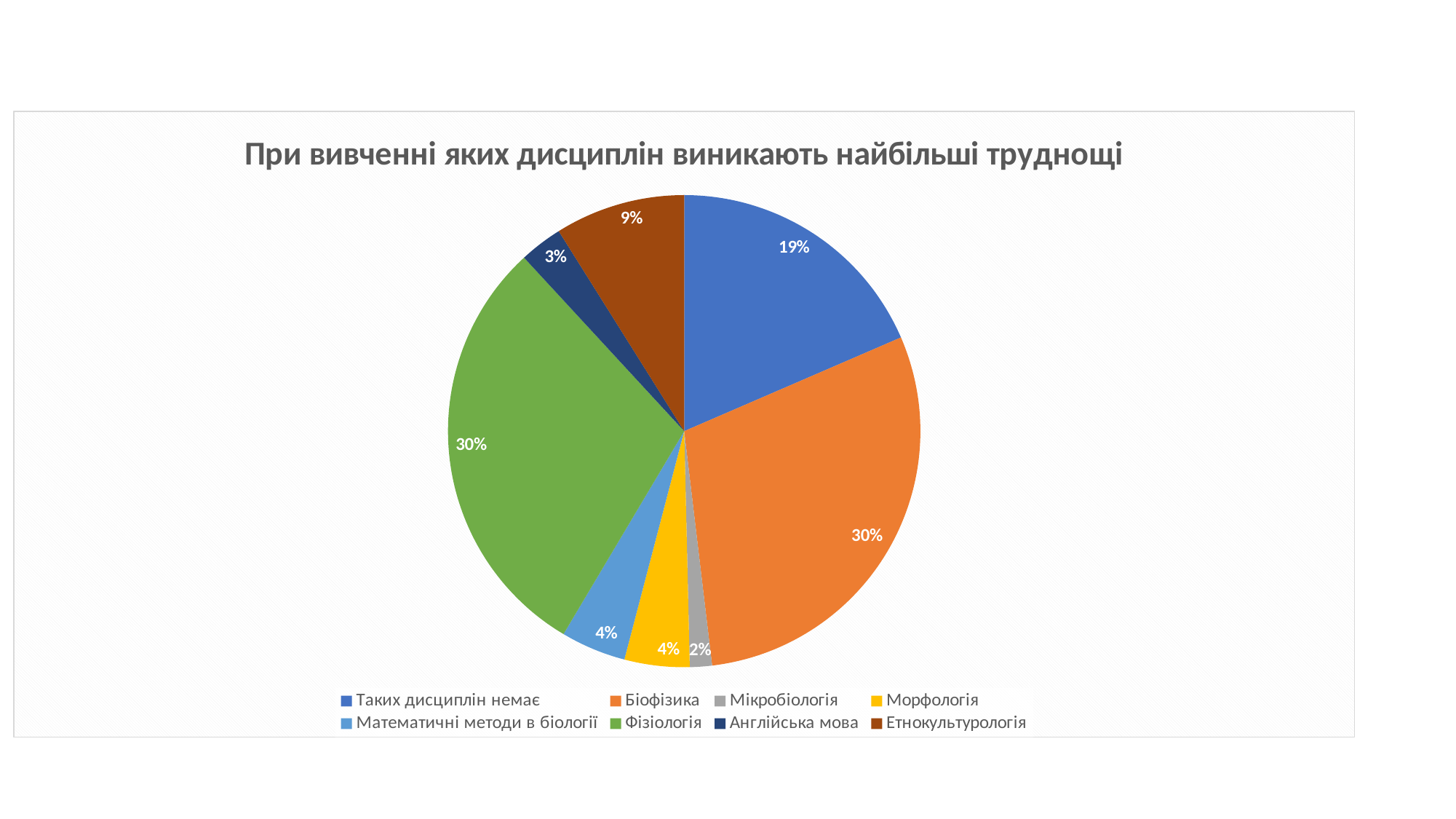
What percentage is shown for Англійська мова? 3% How many categories does the pie chart have? 8 Which is larger, the slice for Таких дисциплін немає or the slice for Етнокультурологія? Таких дисциплін немає What colour is the slice for Морфологія? yellow What is the difference in percentage points between Фізіологія and Таких дисциплін немає? 11 What percentage is shown for Мікробіологія? 2% Which category has the smallest slice of the pie? Мікробіологія What is the title of the chart? При вивченні яких дисциплін виникають найбільші труднощі What share of the pie does Біофізика have? 30% What percentage is shown for Таких дисциплін немає? 19% What kind of chart is shown on the slide? pie chart What percentage is shown for Етнокультурологія? 9%